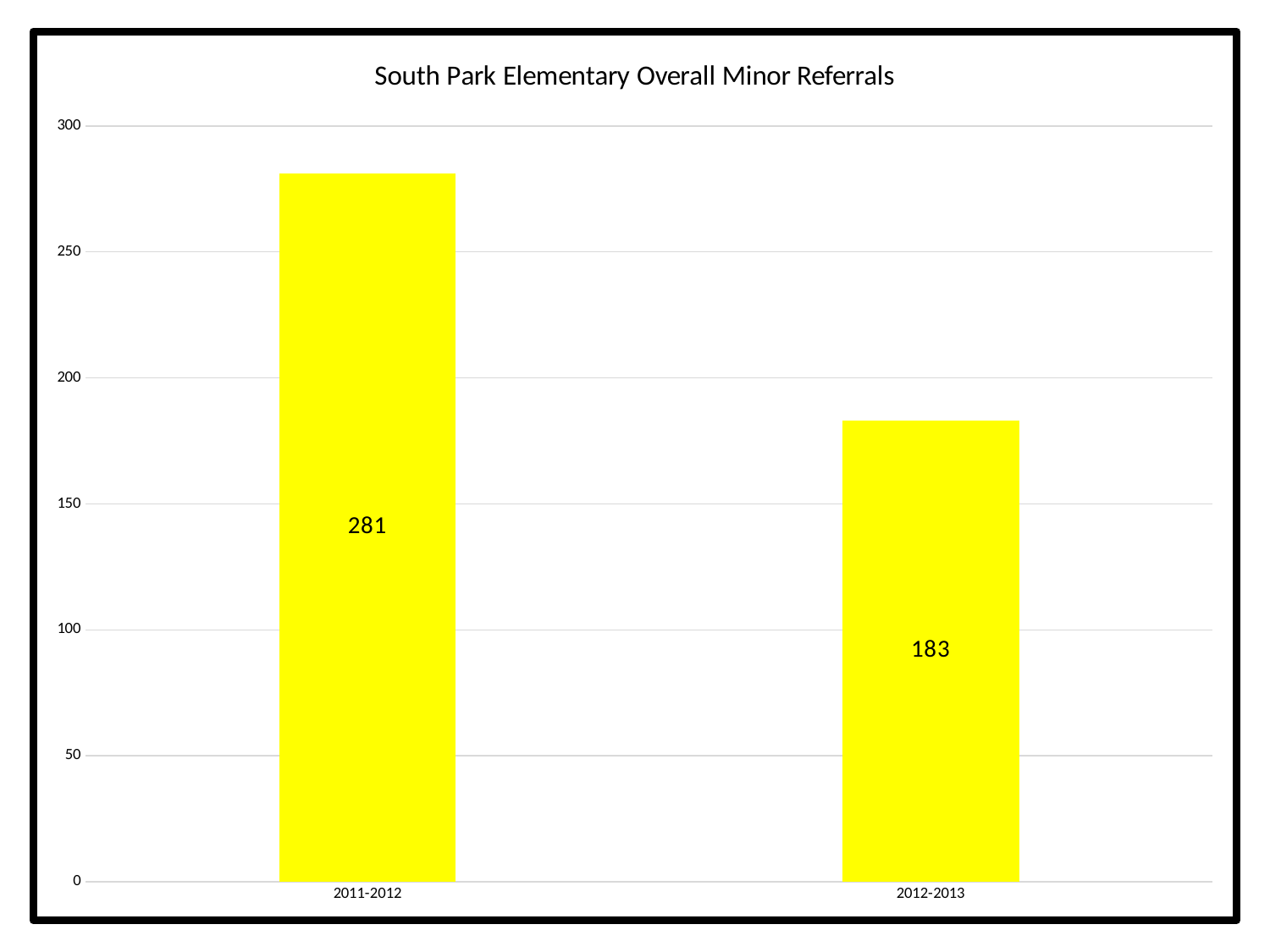
Which is larger, the value for 2011-2012 or the value for 2012-2013? 2011-2012 What is the title of the chart? South Park Elementary Overall Minor Referrals Which year has the lowest number of minor referrals? 2012-2013 Do the values rise or fall from 2011-2012 to 2012-2013? fall What is the value for 2012-2013? 183 What is the value for 2011-2012? 281 What is the difference between the values for 2011-2012 and 2012-2013? 98 Which year has the highest number of minor referrals? 2011-2012 How many categories are shown on the x axis? 2 What kind of chart is shown on the slide? bar chart Is the value for 2012-2013 greater or less than 200? less Is the value for 2011-2012 greater or less than 250? greater